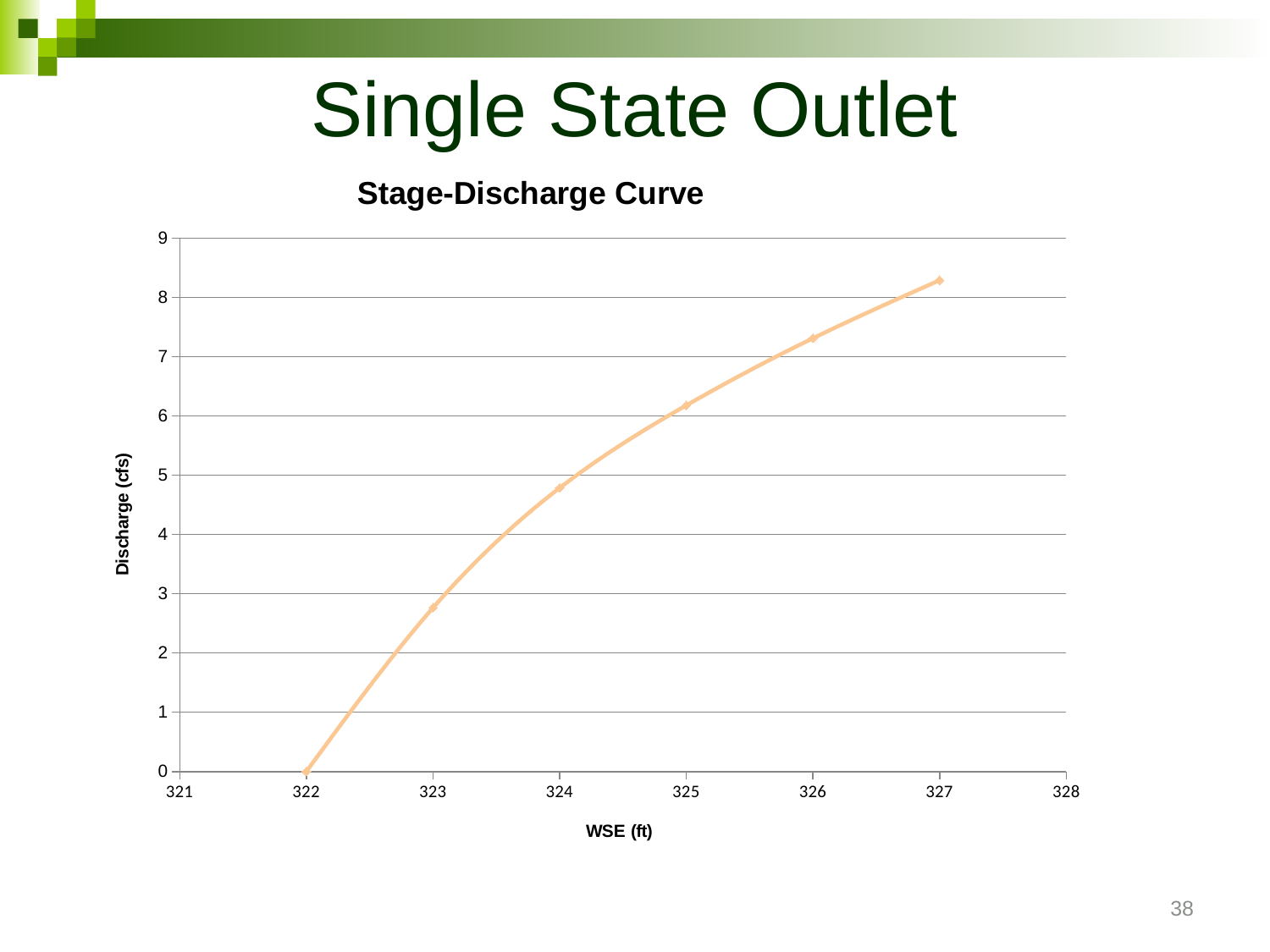
At which WSE value is the discharge highest? 327 What is the label of the vertical axis? Discharge (cfs) What kind of chart is shown on the slide? line chart Is the discharge at a WSE of 324 ft greater or less than 5? less Is the discharge at a WSE of 325 ft greater or less than 6? greater Is the discharge at a WSE of 326 ft greater or less than 7? greater How many data points are plotted on the curve? 6 What is the discharge value at a WSE of 322 ft? 0 What is the title of the chart? Stage-Discharge Curve Does the discharge rise or fall as WSE increases? rises